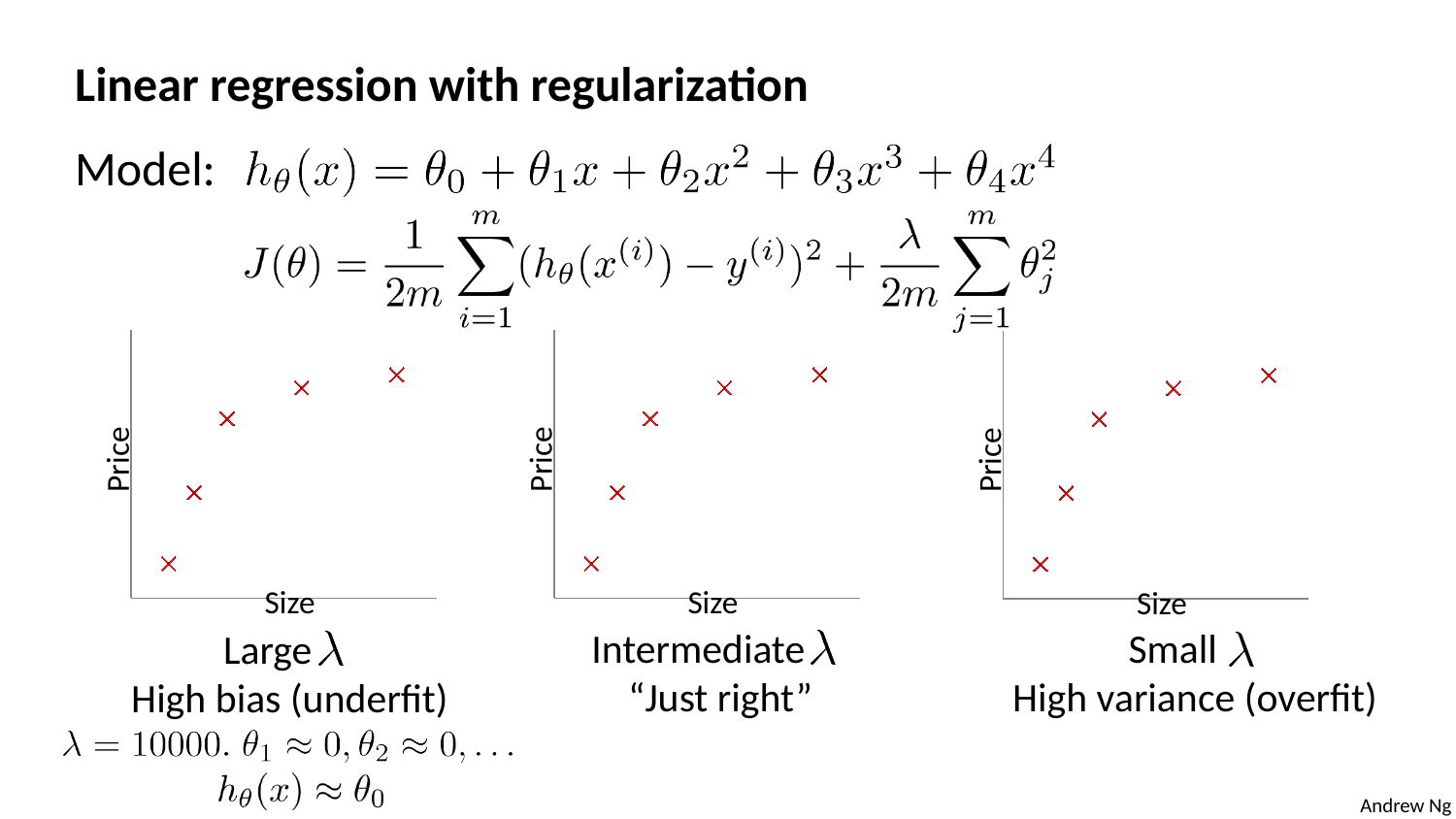
What kind of chart is the left chart labeled "Large λ"? scatter plot What is the x-axis label of the left chart labeled "Large λ"? Size In the right chart labeled "Small λ", do the plotted values rise or fall as Size increases? rise How many charts are shown on the slide? 3 How many data points are plotted in the right chart labeled "Small λ"? 5 How many data points are plotted in the left chart labeled "Large λ"? 5 In the middle chart labeled "Intermediate λ", do the plotted values rise or fall as Size increases? rise What is the y-axis label of the right chart labeled "Small λ"? Price